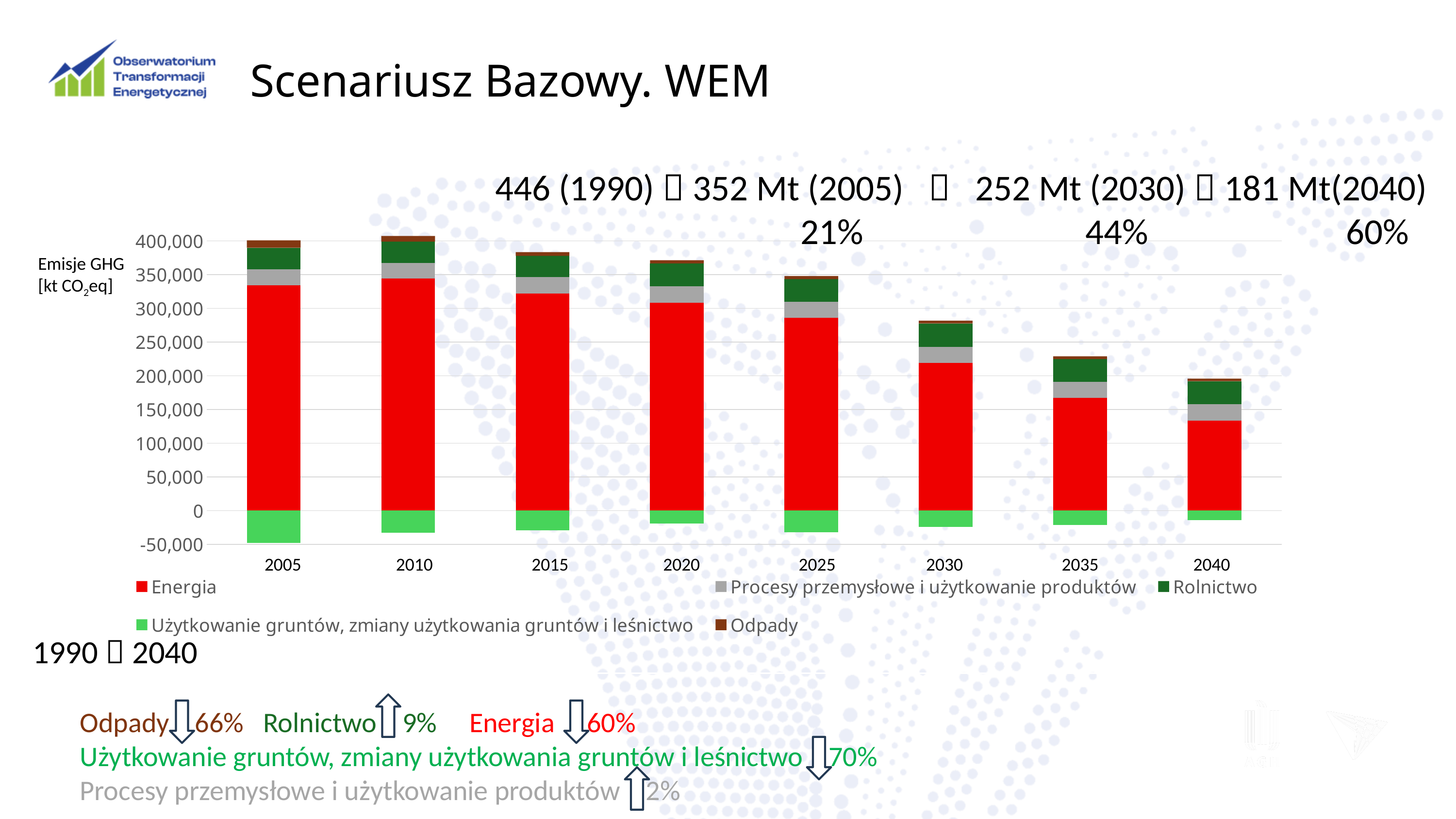
What kind of chart is shown on the slide? stacked bar chart Do the total positive emissions rise or fall from 2010 to 2040 along the x axis? fall Is the value for Energia in 2040 greater or less than 150,000? less Which is larger, the Energia value in 2005 or in 2040? 2005 How many series does the chart legend list? 5 What colour represents the Energia series in the chart? red Is the value for Energia in 2005 greater or less than 300,000? greater Which is larger, the Rolnictwo value in 2005 or the Odpady value in 2005? Rolnictwo Is the value for Energia in 2030 greater or less than 200,000? greater How many years are shown on the x axis of the chart? 8 Which year has the lowest total positive stacked emissions? 2040 Which series is plotted below zero in every year? Użytkowanie gruntów, zmiany użytkowania gruntów i leśnictwo